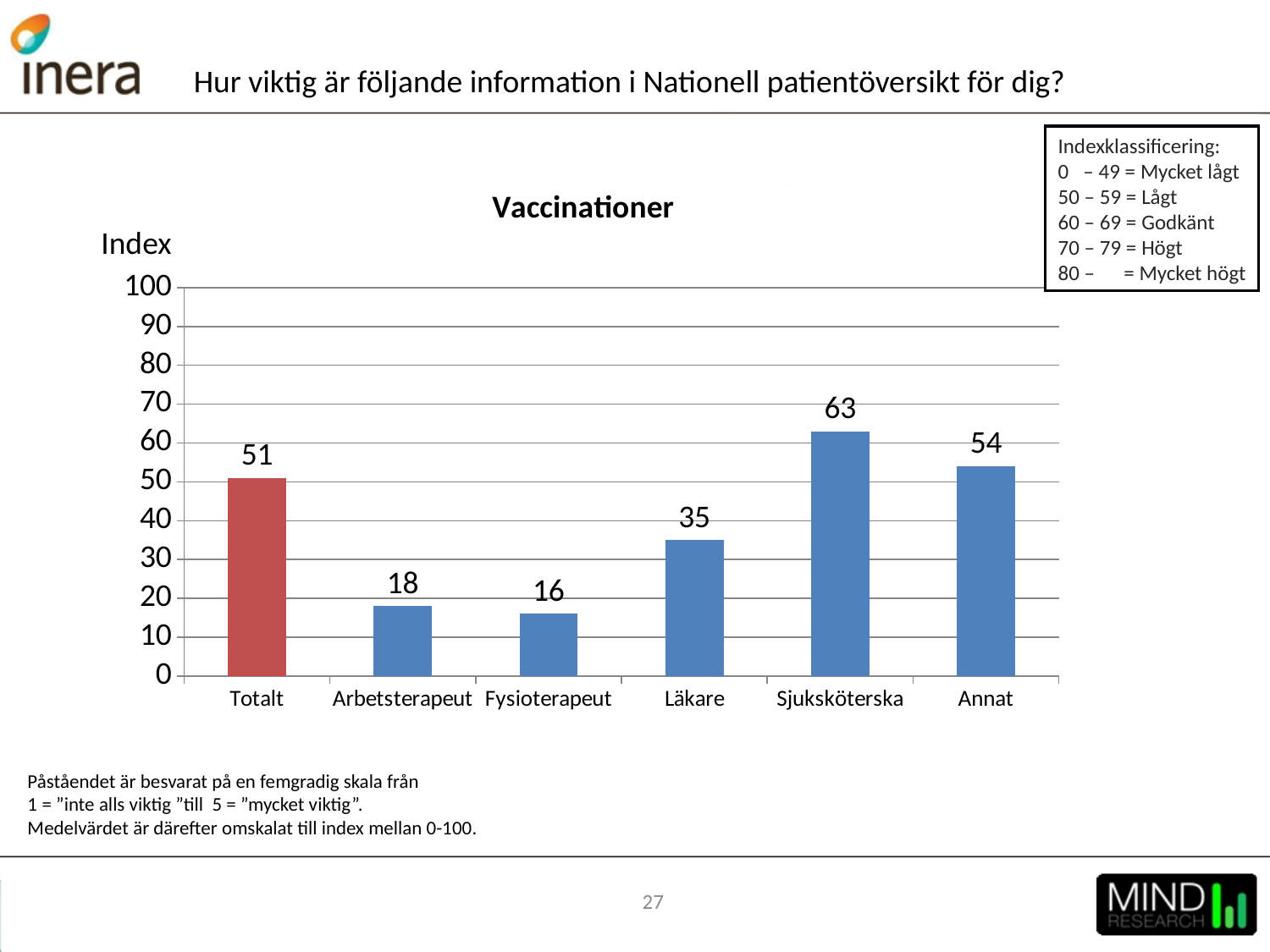
Is the value for Arbetsterapeut greater or less than 20? less Which category has the lowest index value? Fysioterapeut What is the difference between the index values for Sjuksköterska and Läkare? 28 Which has a higher index value, Annat or Läkare? Annat What is the index value for Totalt? 51 What is the index value for Sjuksköterska? 63 What is the index value for Fysioterapeut? 16 Which bar is coloured red rather than blue? Totalt What is the title of the chart? Vaccinationer Which category has the highest index value? Sjuksköterska How many categories are shown on the x axis? 6 What kind of chart is shown? bar chart